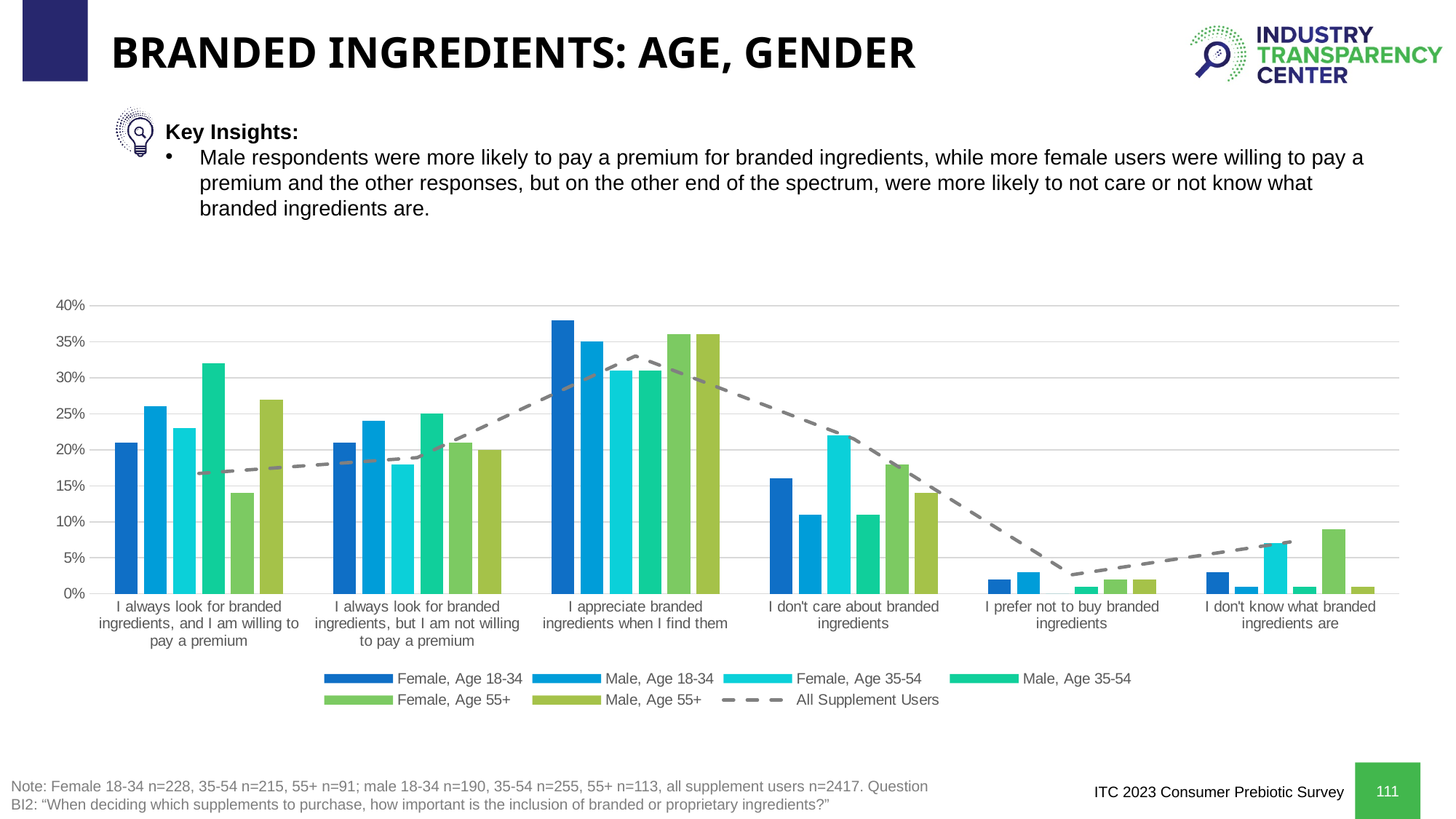
What kind of chart is shown on the slide? combination bar and line chart Is the value for Male, Age 35-54 in "I always look for branded ingredients, and I am willing to pay a premium" greater or less than 30%? greater Which series has the lowest value in "I always look for branded ingredients, and I am willing to pay a premium"? Female, Age 55+ Which series is drawn as a dashed line rather than bars? All Supplement Users Is the value for Female, Age 35-54 in "I don't care about branded ingredients" greater or less than 20%? greater How many series does the legend list? 7 Is the value for Female, Age 18-34 in "I appreciate branded ingredients when I find them" greater or less than 35%? greater How many response categories are shown along the x axis? 6 In "I don't care about branded ingredients", which is larger: Female, Age 35-54 or Female, Age 55+? Female, Age 35-54 For which category does the All Supplement Users line reach its highest point? I appreciate branded ingredients when I find them Which series has the highest value in "I always look for branded ingredients, and I am willing to pay a premium"? Male, Age 35-54